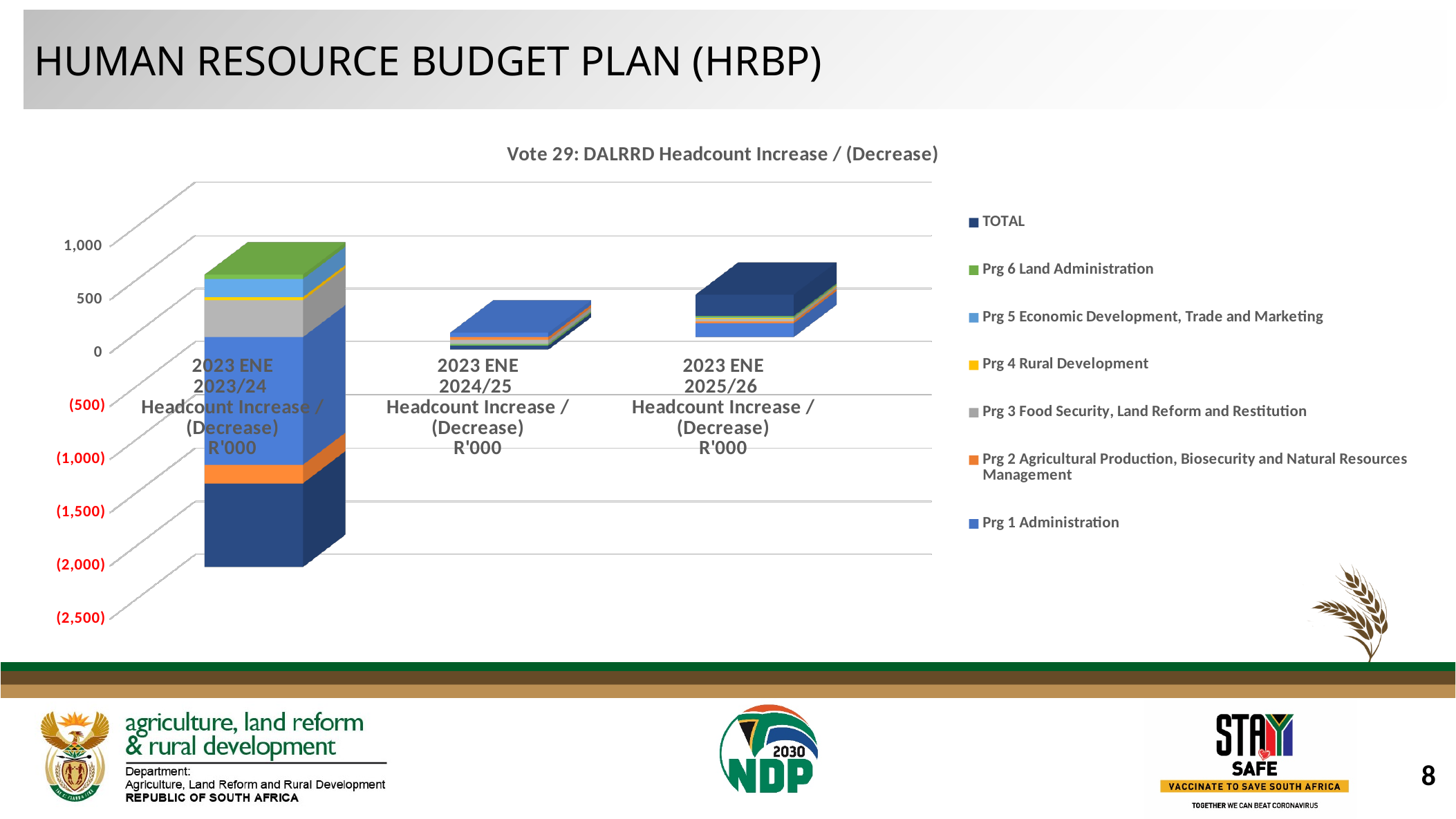
How many series does the chart legend list? 7 How many financial-year categories are plotted along the x axis? 3 Which financial year's stacked bar extends furthest below 0? 2023 ENE 2023/24 Is the Prg 1 Administration value for 2023 ENE 2023/24 greater or less than 0? less Is the Prg 6 Land Administration value for 2023 ENE 2023/24 greater or less than 0? greater Is the TOTAL value for 2023 ENE 2023/24 greater or less than 0? less Which colour represents Prg 4 Rural Development in the legend? Yellow What type of chart is shown on the slide? Bar chart Which financial year has the largest negative Prg 1 Administration segment? 2023 ENE 2023/24 What is the title of the chart? Vote 29: DALRRD Headcount Increase / (Decrease)